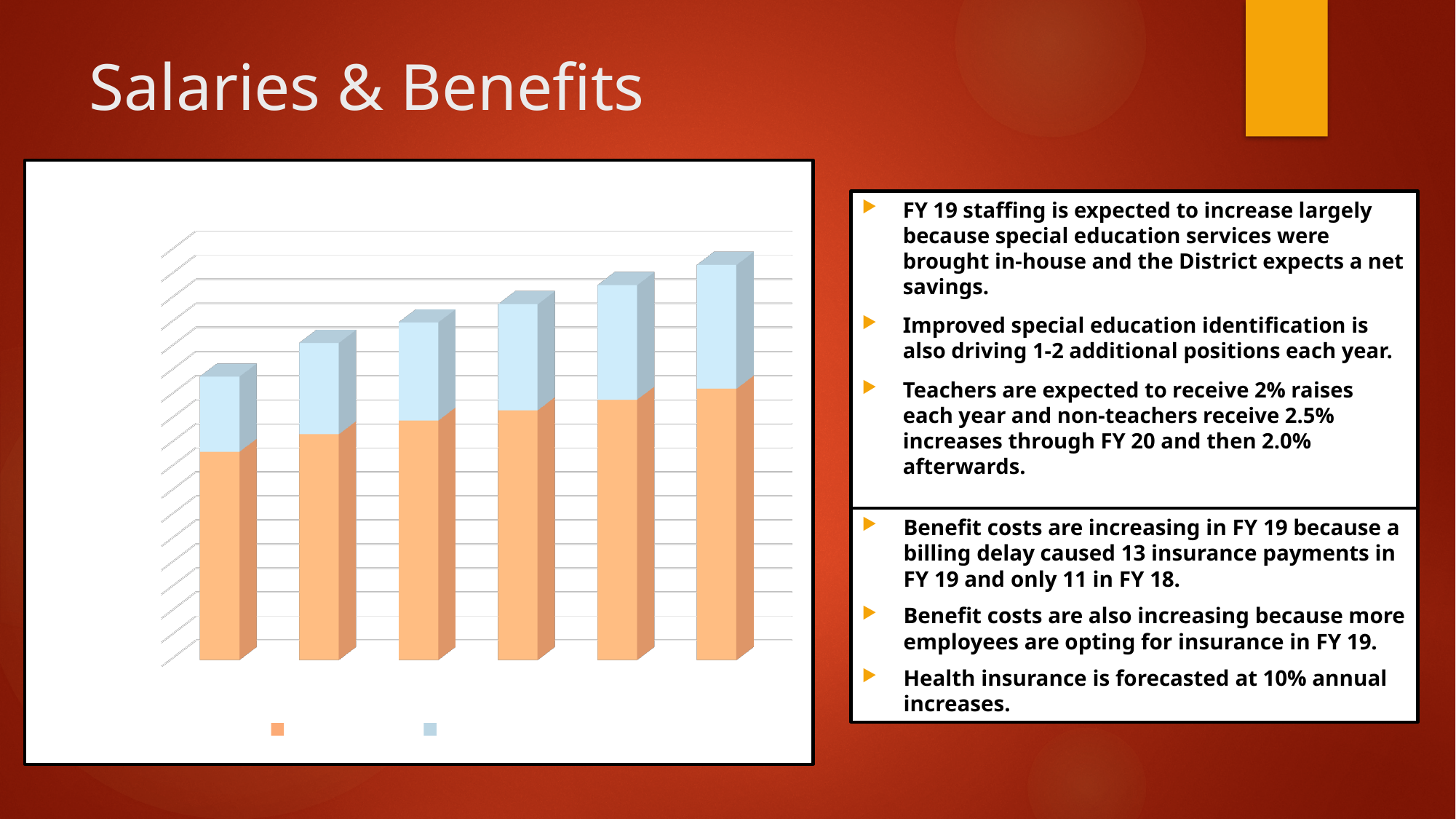
What colour is the top segment of each stacked bar? light blue Which bar is the shortest in the chart, the leftmost or the rightmost? leftmost How many series does the chart's legend list? 2 What kind of chart is shown on the slide? stacked bar chart In each bar, which segment is larger, the orange (bottom) segment or the blue (top) segment? orange (bottom) How many bars are plotted in the chart? 6 What colour is the bottom segment of each stacked bar? orange Do the total bar heights rise or fall from left to right across the chart? rise Which bar is the tallest in the chart, the leftmost or the rightmost? rightmost